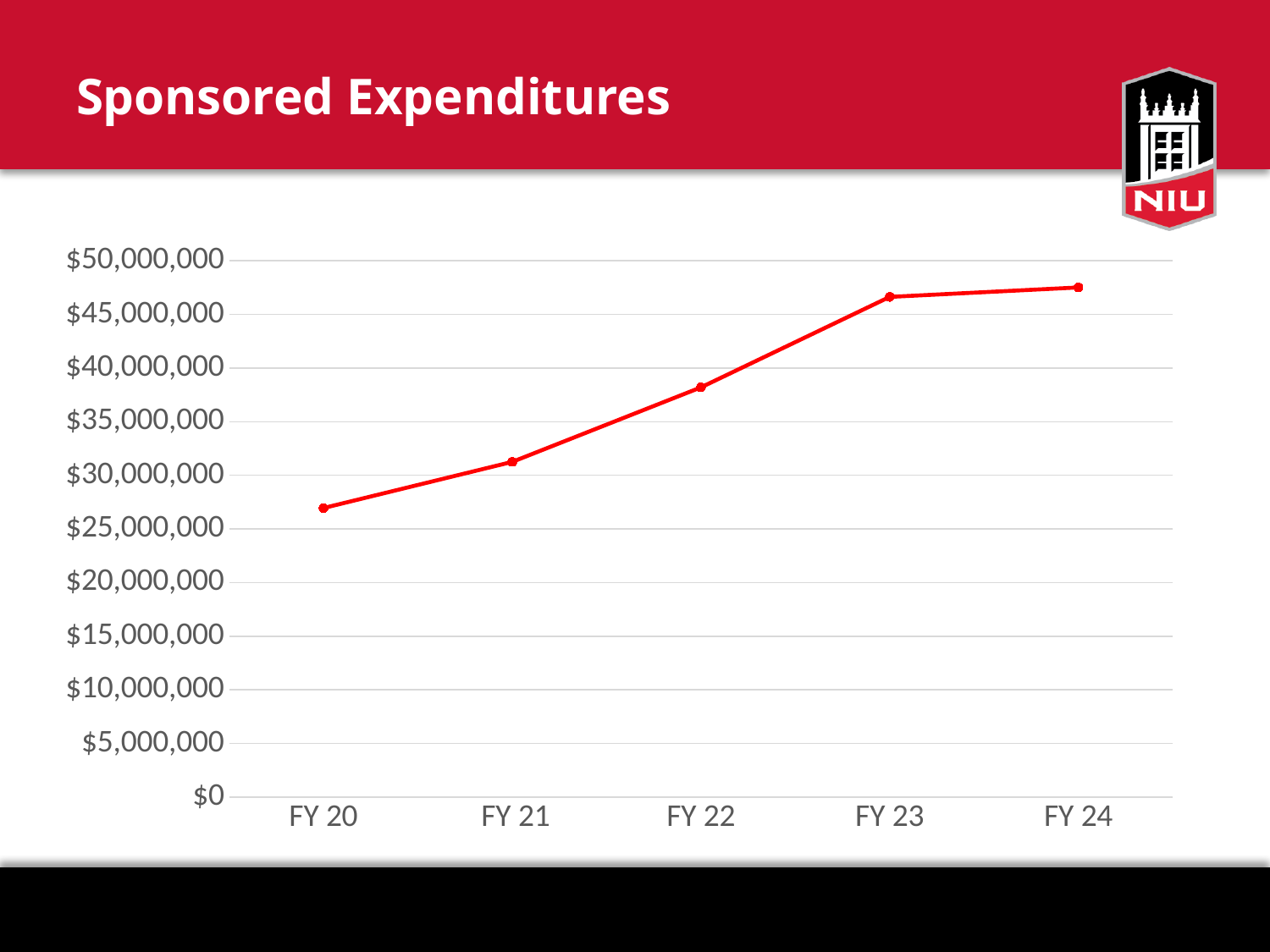
How many fiscal years are plotted on the chart? 5 Which is larger, the value for FY 22 or the value for FY 23? FY 23 Is the value for FY 22 greater or less than $40,000,000? less Is the value for FY 20 greater or less than $30,000,000? less Which fiscal year has the lowest sponsored expenditures? FY 20 What is the title of the chart? Sponsored Expenditures Is the value for FY 23 greater or less than $45,000,000? greater What kind of chart is shown on the slide? line chart Do sponsored expenditures rise or fall from FY 20 to FY 24? rise